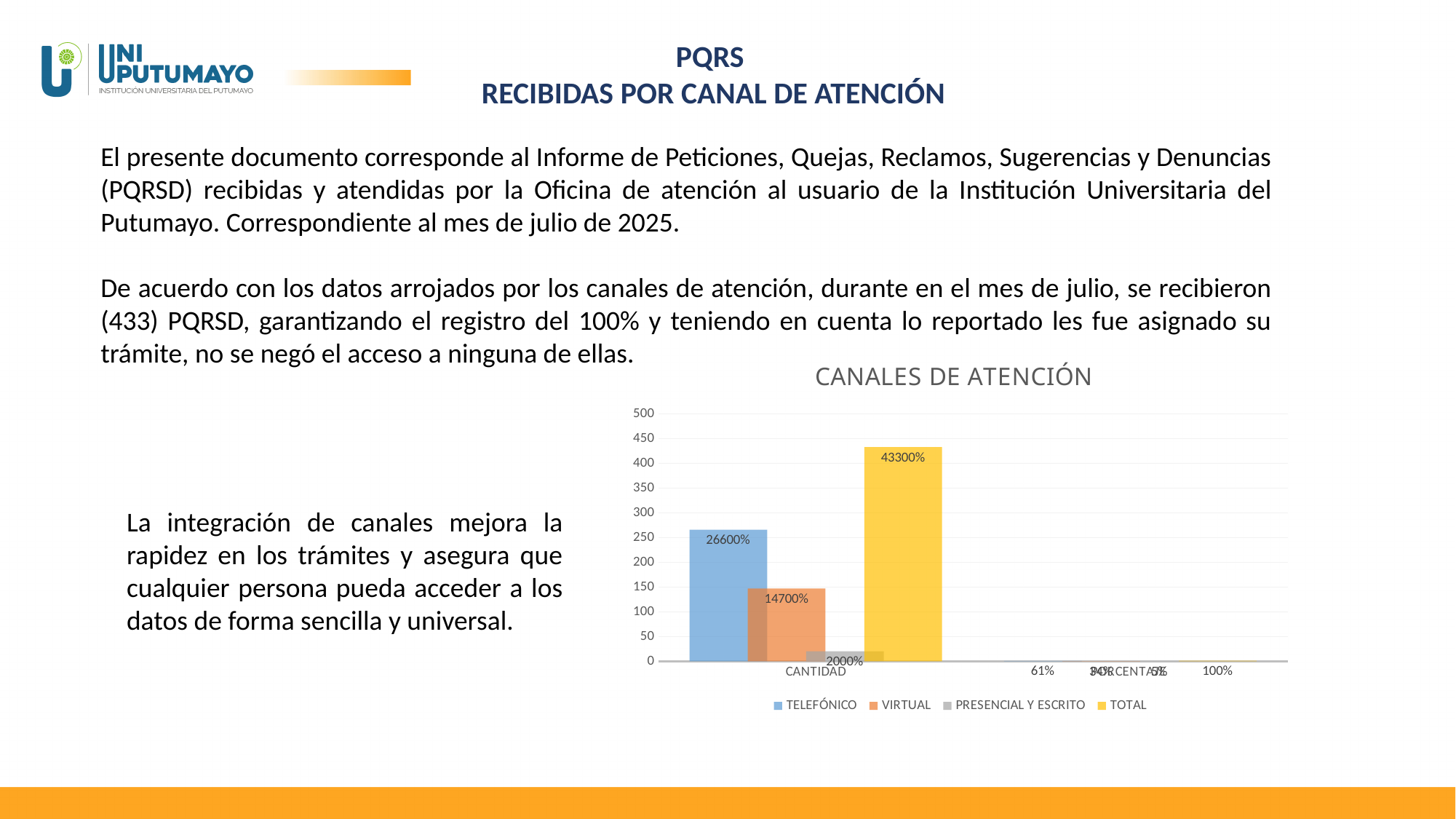
What is the title of the chart? CANALES DE ATENCIÓN What is the data label on the TELEFÓNICO bar for CANTIDAD? 26600% What kind of chart is shown on the slide? bar chart How many series does the chart legend list? 4 Which series has the tallest bar in the CANTIDAD group? TOTAL In the CANTIDAD group, which bar is taller: TELEFÓNICO or VIRTUAL? TELEFÓNICO Which series has the shortest bar in the CANTIDAD group? PRESENCIAL Y ESCRITO Is the TELEFÓNICO bar for CANTIDAD greater or less than 250 on the axis? greater What is the data label on the PRESENCIAL Y ESCRITO bar for CANTIDAD? 2000% What is the data label on the TOTAL bar for CANTIDAD? 43300% What is the data label shown for TELEFÓNICO in the PORCENTAJE group? 61% What is the data label on the VIRTUAL bar for CANTIDAD? 14700%